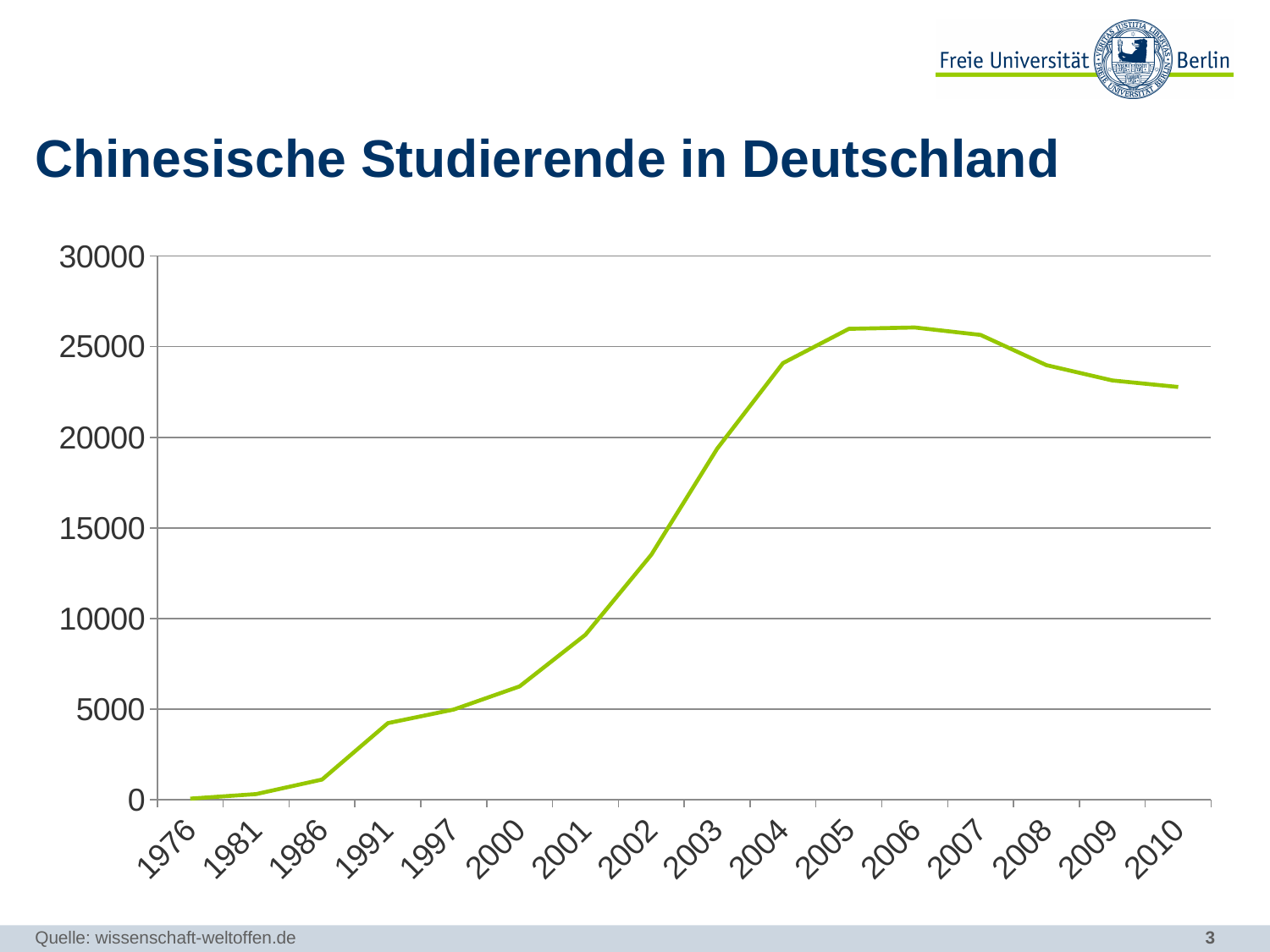
What is the title of the chart? Chinesische Studierende in Deutschland Which year has the lowest value on the chart? 1976 Is the value for 2008 greater or less than 25000? less What kind of chart is shown on the slide? Line chart Does the line rise or fall between 1976 and 2005? Rises Is the value for 2010 greater or less than 20000? greater Does the line rise or fall between 2006 and 2010? Falls Is the value for 1991 greater or less than 5000? less Which year has the larger value, 2002 or 2004? 2004 How many years are plotted along the x axis? 16